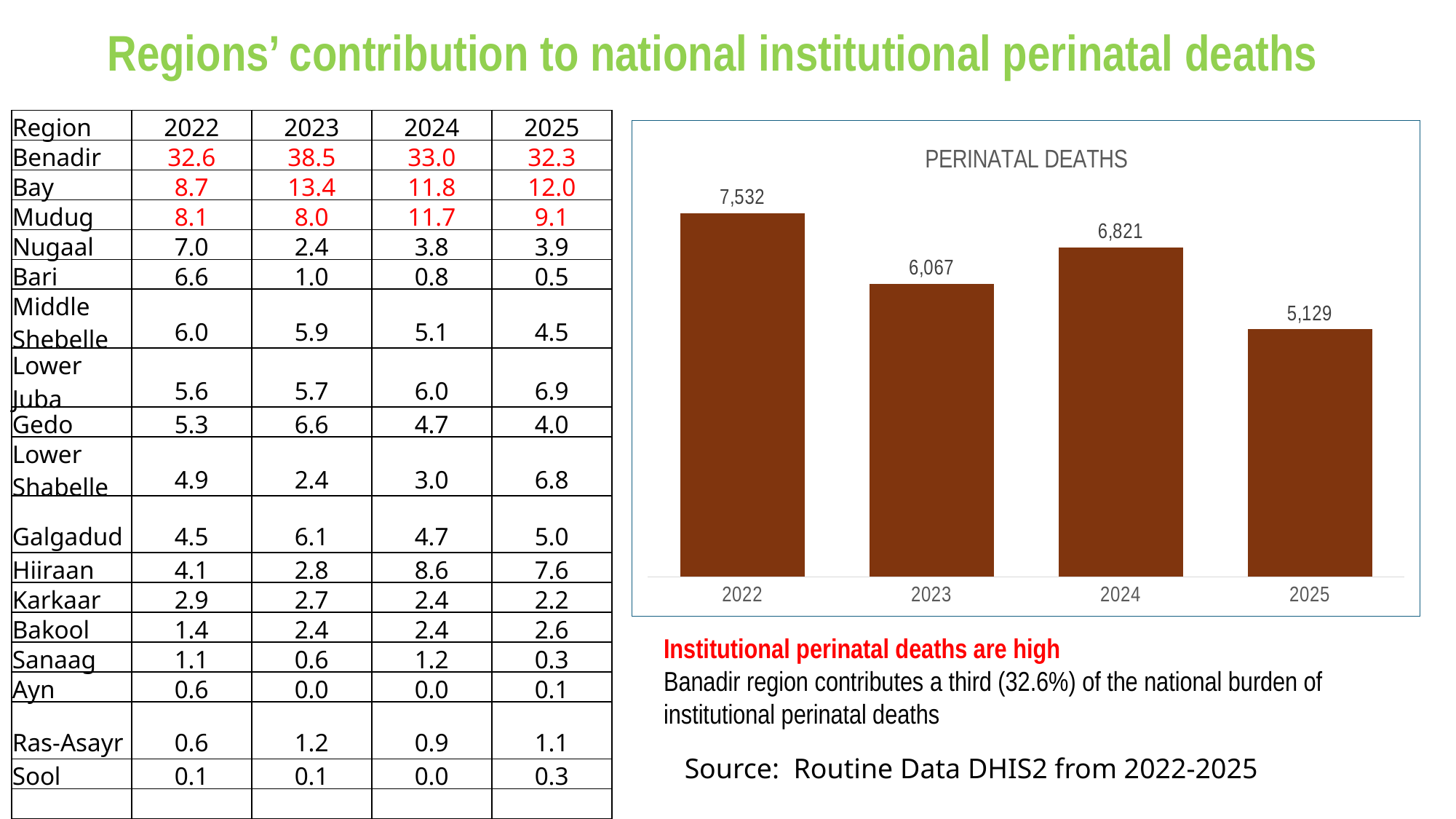
What is the title of the chart on the slide? PERINATAL DEATHS What is the value for 2023 in the PERINATAL DEATHS chart? 6,067 Which year has the highest number of perinatal deaths in the chart? 2022 Do perinatal deaths rise or fall from 2024 to 2025 in the chart? Fall What is the difference between the perinatal deaths in 2024 and 2023? 754 What is the value for 2022 in the PERINATAL DEATHS chart? 7,532 What is the value for 2025 in the PERINATAL DEATHS chart? 5,129 What kind of chart is the PERINATAL DEATHS chart? Bar chart What is the difference between the perinatal deaths in 2022 and 2025? 2,403 Which year has the lowest number of perinatal deaths in the chart? 2025 Which year has more perinatal deaths, 2023 or 2024? 2024 How many years are shown in the PERINATAL DEATHS chart? 4